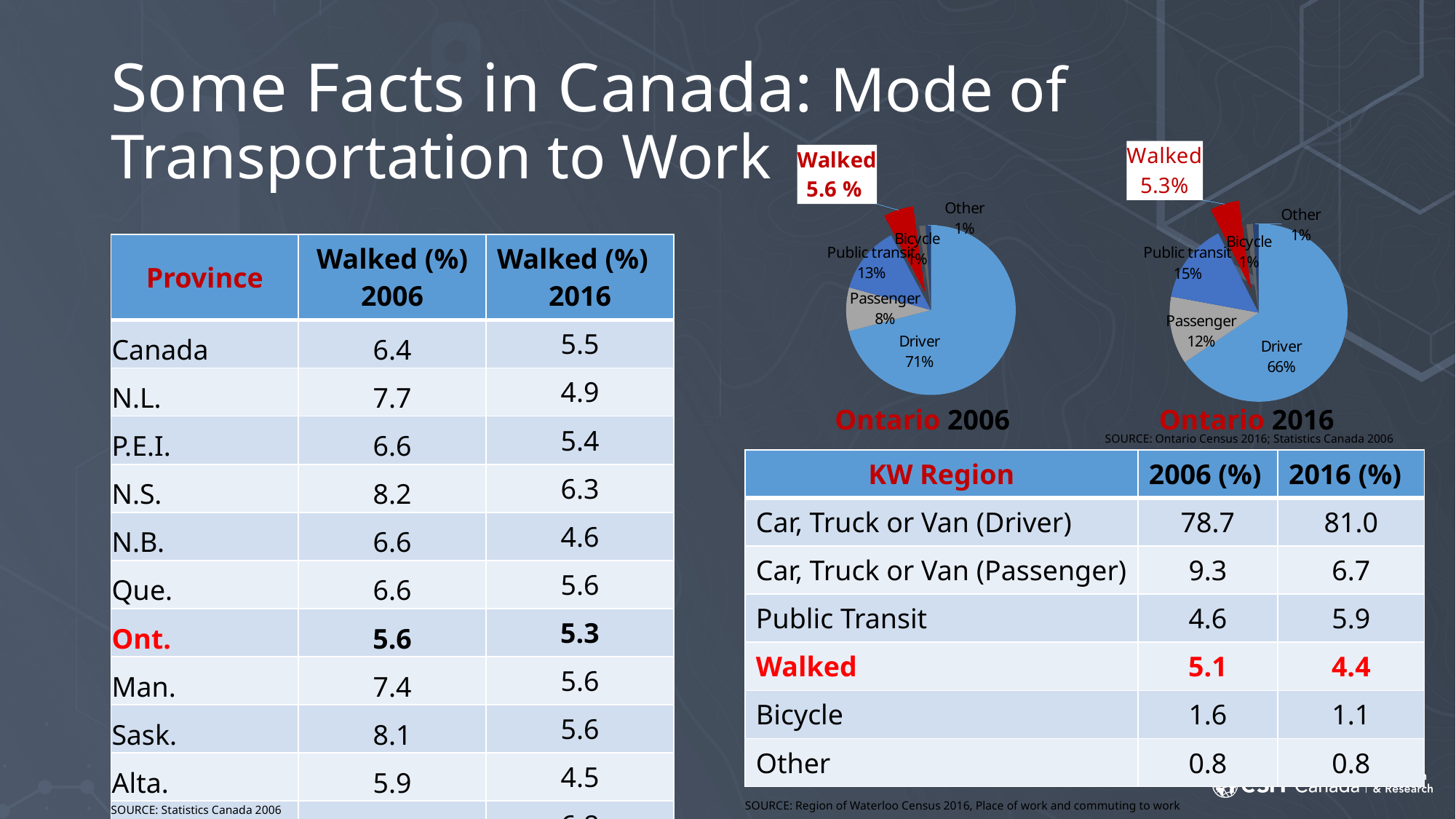
In the Ontario 2006 pie chart, which is larger, Public transit or Passenger? Public transit In the Ontario 2016 pie chart, what percentage is shown for Public transit? 15% In the Ontario 2006 pie chart, what percentage is shown for Passenger? 8% In the Ontario 2016 pie chart, what value is shown in the callout for Walked? 5.3% In the Ontario 2016 pie chart, what share of the pie is Driver? 66% In the Ontario 2016 pie chart, which category has the largest slice? Driver In the Ontario 2006 pie chart, what percentage is shown for Public transit? 13% In the Ontario 2006 pie chart, what value is shown in the callout for Walked? 5.6 % What is the difference between the Driver share in the Ontario 2006 pie chart and the Driver share in the Ontario 2016 pie chart? 5% What kind of chart is the Ontario 2006 chart? Pie chart In the Ontario 2016 pie chart, what percentage is shown for Passenger? 12% In the Ontario 2006 pie chart, what share of the pie is Driver? 71%